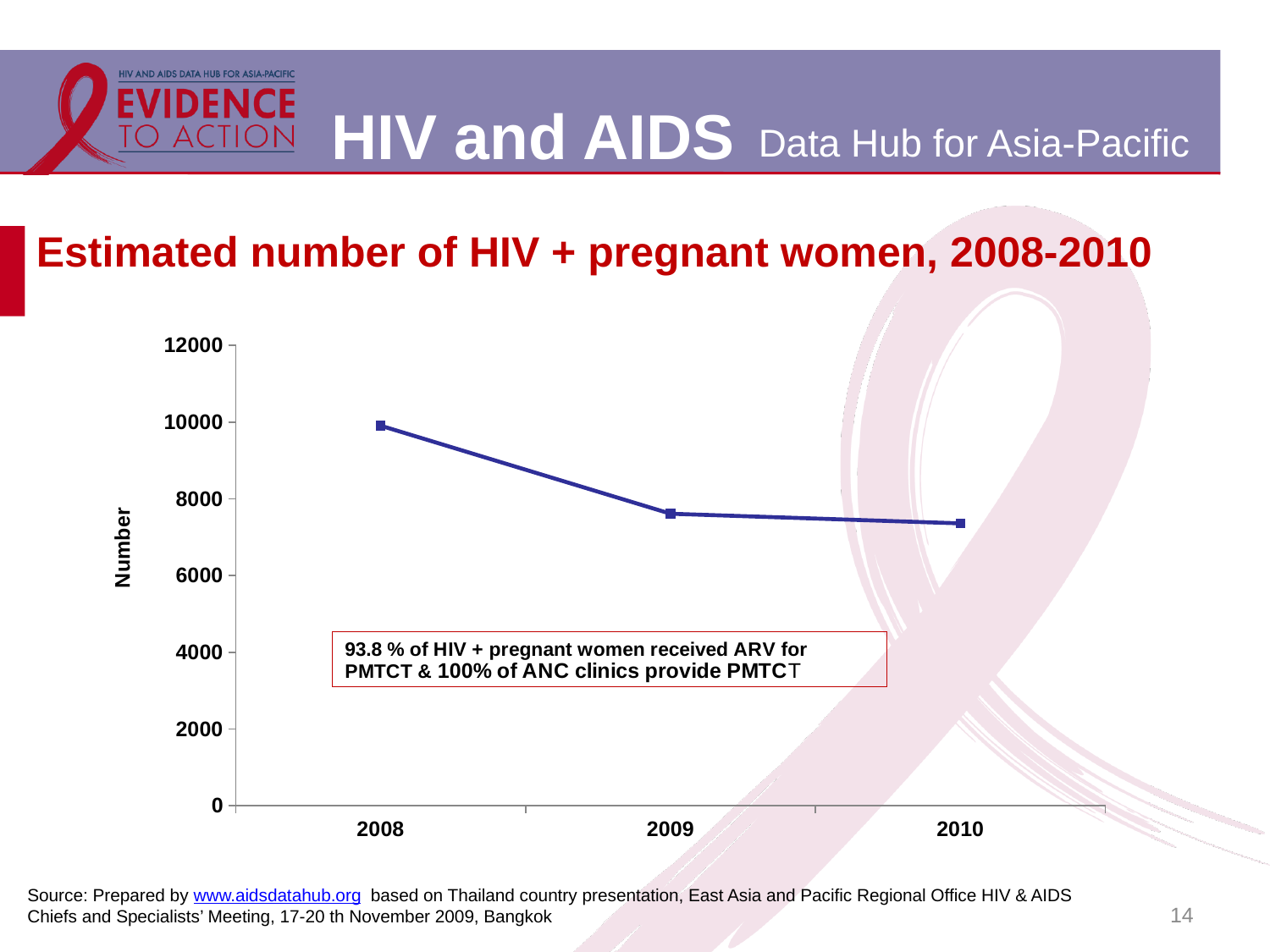
What is the highest value shown on the y axis? 12000 Is the value for 2008 greater or less than 8000? greater Is the value for 2010 greater or less than 8000? less Do the values rise or fall from 2008 to 2010? fall Which year has the highest estimated number of HIV + pregnant women? 2008 Which is larger, the value for 2008 or the value for 2009? 2008 How many years are plotted on the x axis? 3 Is the value for 2009 greater or less than 8000? less What kind of chart is shown on the slide? line chart What is the title of the chart? Estimated number of HIV + pregnant women, 2008-2010 What is the label on the y axis? Number